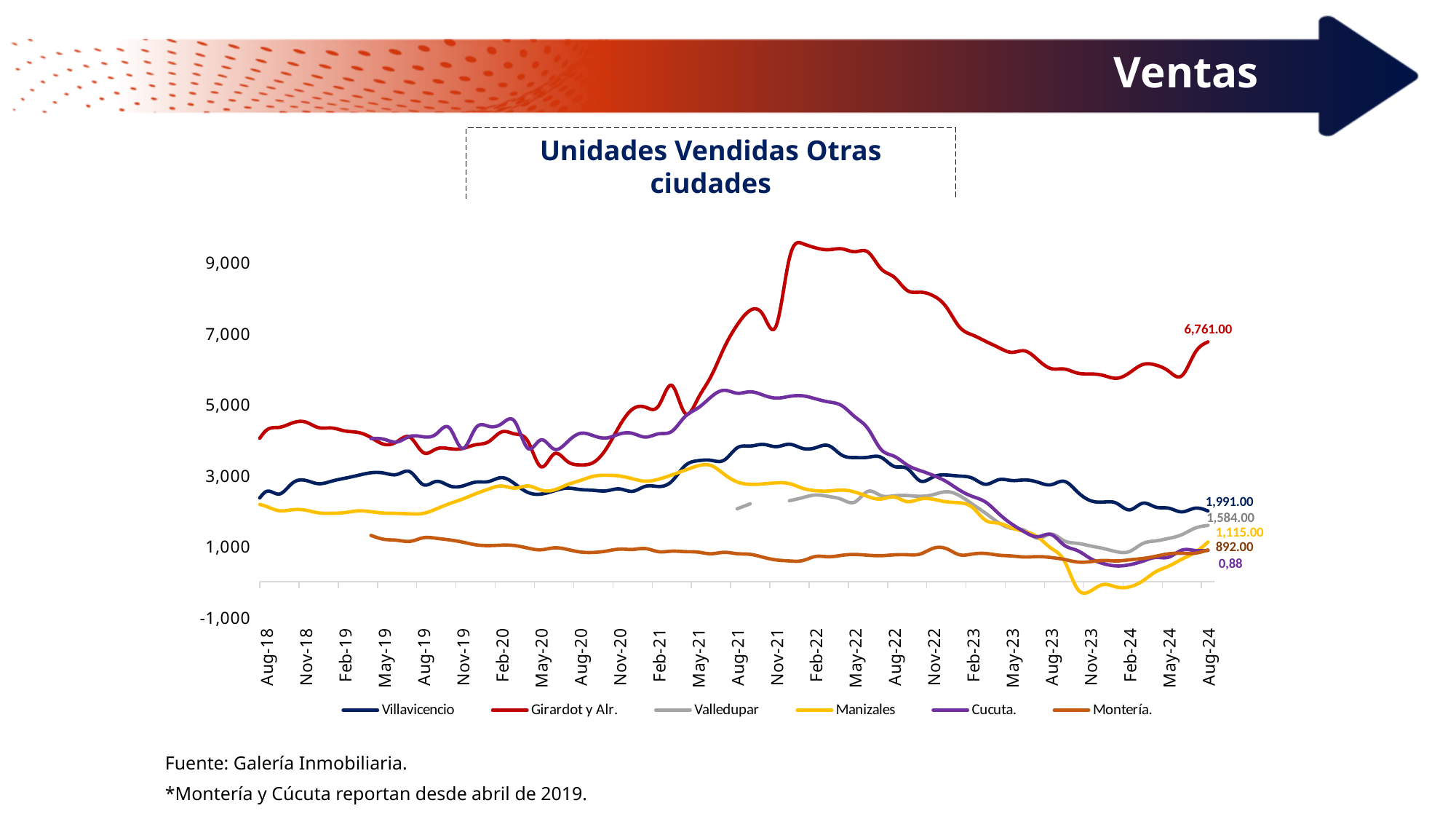
What is the value for Valledupar at Aug-24? 1,584.00 How many series does the legend list? 6 What is the value for Manizales at Aug-24? 1,115.00 What is the value for Montería at Aug-24? 892.00 What is the value for Girardot y Alr. at Aug-24? 6,761.00 At Aug-24, which is larger: Valledupar or Manizales? Valledupar What is the value for Villavicencio at Aug-24? 1,991.00 What is the difference between Girardot y Alr. and Villavicencio at Aug-24? 4,770.00 What is the title of the chart? Unidades Vendidas Otras ciudades What kind of chart is shown on the slide? line chart Is the peak value for Girardot y Alr. around Nov-21 greater or less than 9,000? greater Which series has the highest value at Aug-24? Girardot y Alr.